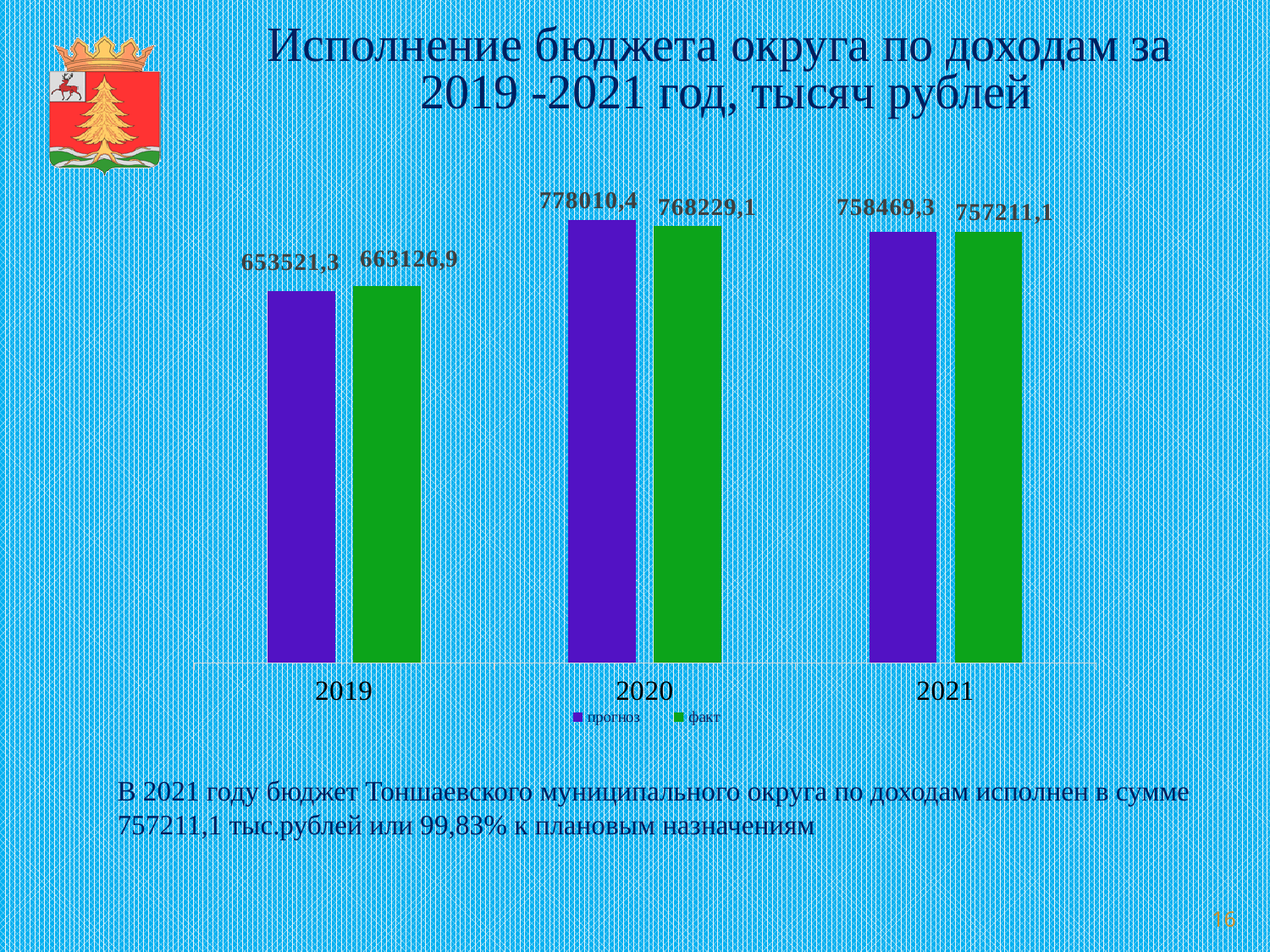
What is the прогноз value for 2020? 778010,4 In which year is the факт value lowest? 2019 What is the факт value for 2021? 757211,1 What is the прогноз value for 2019? 653521,3 How many years are shown on the x axis? 3 Which is larger for 2021, the прогноз value or the факт value? прогноз How many series does the legend list? 2 What is the факт value for 2019? 663126,9 What is the difference between the прогноз and факт values for 2020? 9781,3 In which year is the прогноз value highest? 2020 What is the difference between the факт and прогноз values for 2019? 9605,6 What kind of chart is shown on the slide? bar chart